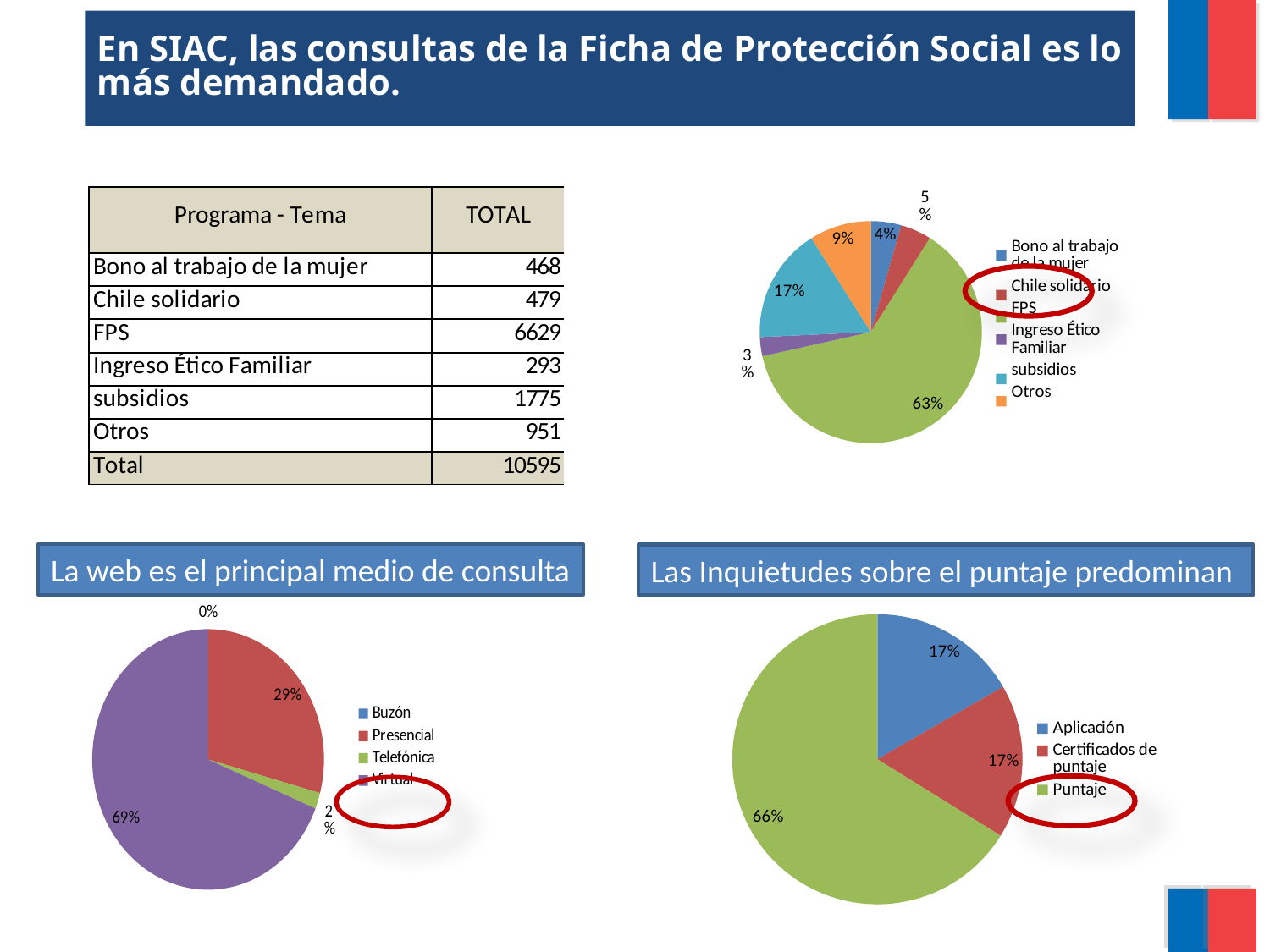
What kind of chart is the top-right chart? Pie chart How many categories does the top-right pie chart show? 6 In the bottom-right pie chart (Las Inquietudes sobre el puntaje predominan), what share does Puntaje have? 66% In the bottom-left pie chart (La web es el principal medio de consulta), which category has the largest slice? Virtual In the top-right pie chart, what share does FPS have? 63% In the top-right pie chart, which category has the smallest slice? Ingreso Ético Familiar In the top-right pie chart, which category has the largest slice? FPS In the top-right pie chart, what share does subsidios have? 17% In the bottom-right pie chart (Las Inquietudes sobre el puntaje predominan), what is the difference in percentage points between Puntaje and Aplicación? 49 percentage points How many categories does the legend of the bottom-left pie chart (La web es el principal medio de consulta) list? 4